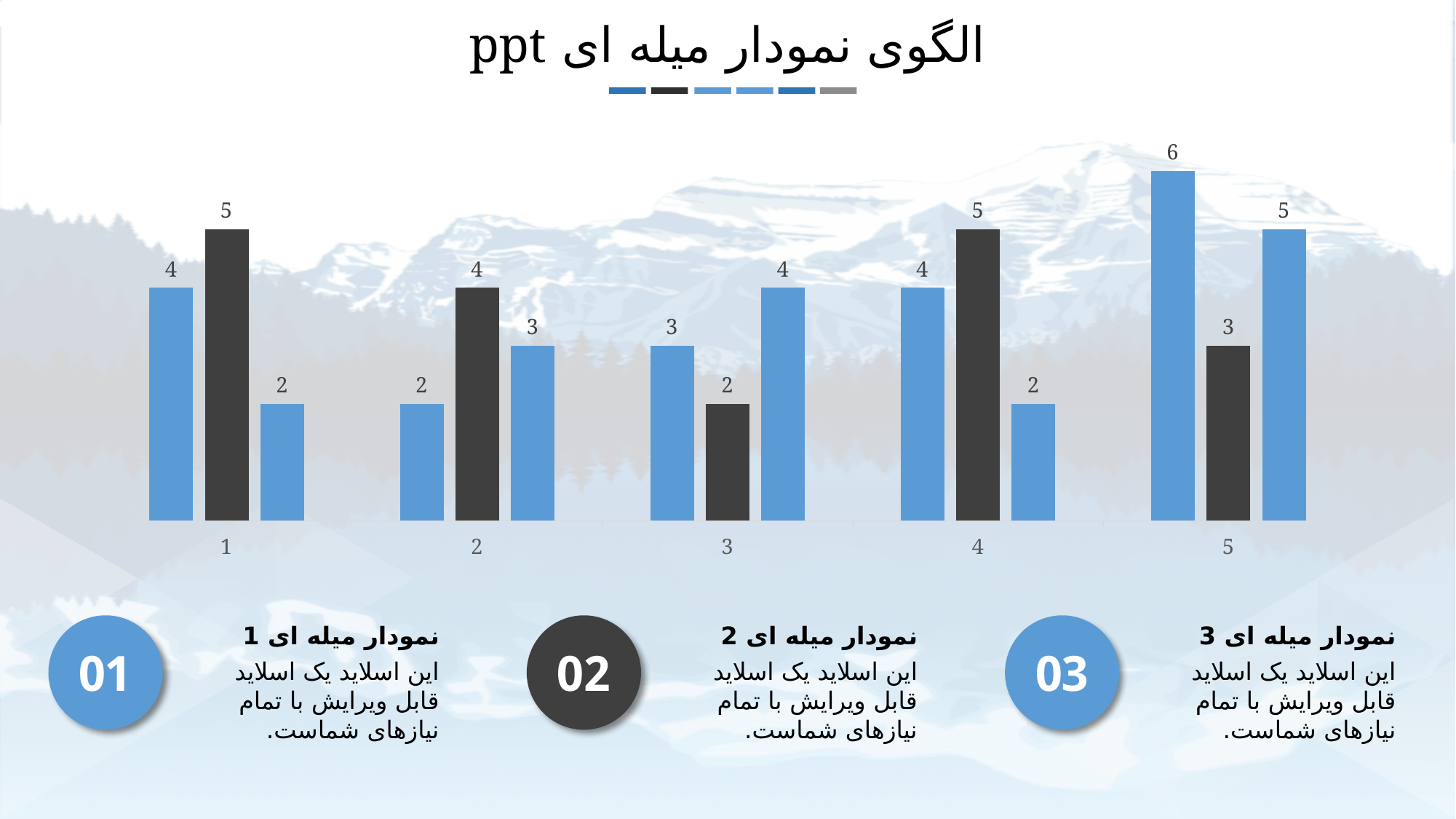
What colours are the bars in the chart? blue and dark grey What is the value of the first (left) blue bar for category 5? 6 What is the value of the third (right) bar for category 2? 3 What is the value of the dark bar for category 1? 5 What is the total of the three bars in category 1? 11 How many bars are plotted for each category? 3 What kind of chart is shown on the slide? bar chart What is the value of the dark bar for category 3? 2 What is the difference between the first bar and the dark bar in category 5? 3 How many categories are shown along the x axis of the chart? 5 Which is larger: the dark bar for category 4 or the dark bar for category 3? the dark bar for category 4 Which category has the tallest bar in the chart? 5